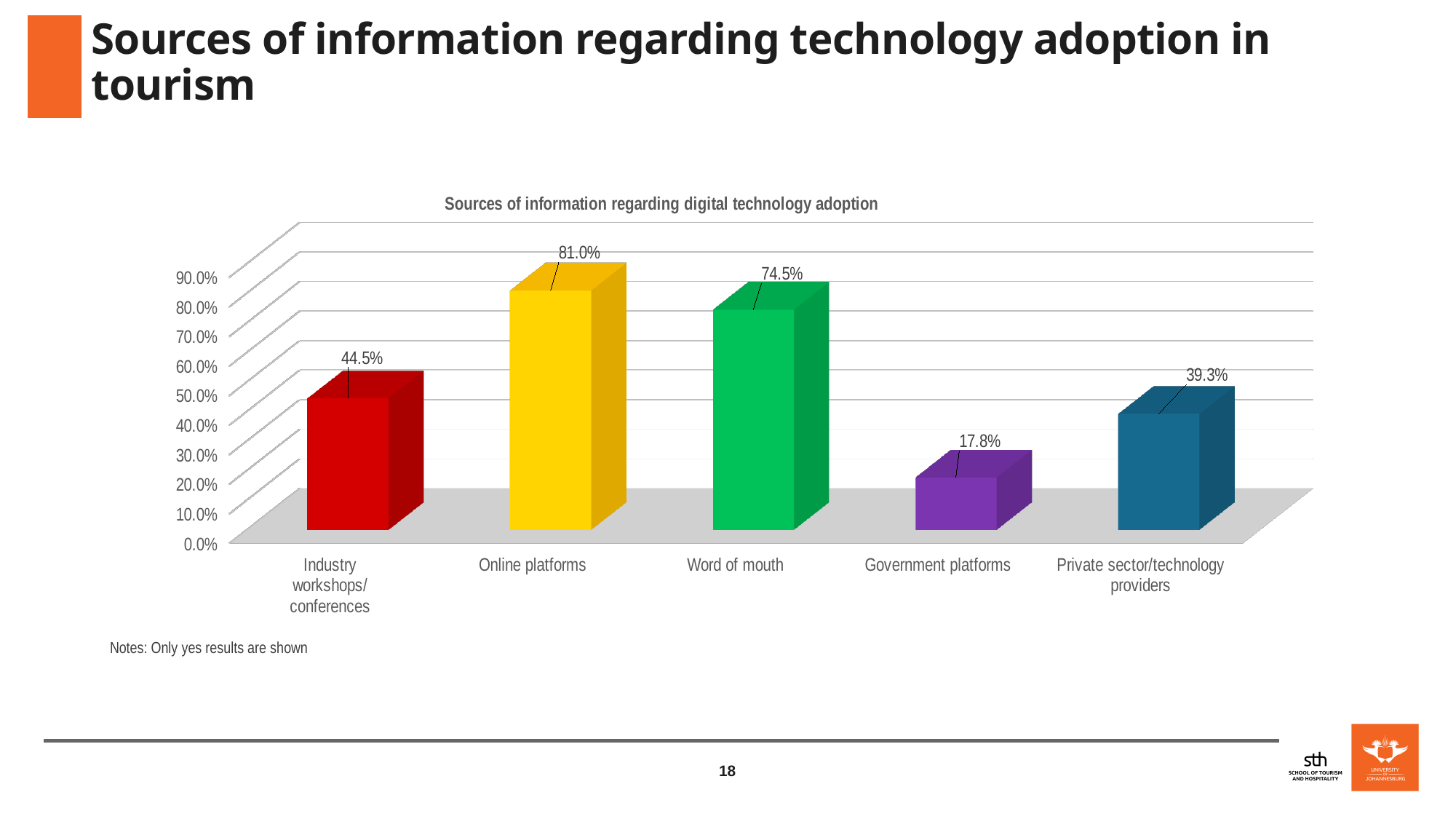
What is the value for Private sector/technology providers? 39.3% What kind of chart is shown on the slide? Bar chart Which is larger, the value for Industry workshops/conferences or Private sector/technology providers? Industry workshops/conferences What is the value for Government platforms? 17.8% Is the value for Word of mouth greater or less than 70.0%? greater What is the value for Online platforms? 81.0% How many categories are shown in the chart? 5 Which source of information has the highest value? Online platforms What is the difference between the values for Online platforms and Word of mouth? 6.5% What is the title of the chart? Sources of information regarding digital technology adoption What is the value for Industry workshops/conferences? 44.5% Which source of information has the lowest value? Government platforms